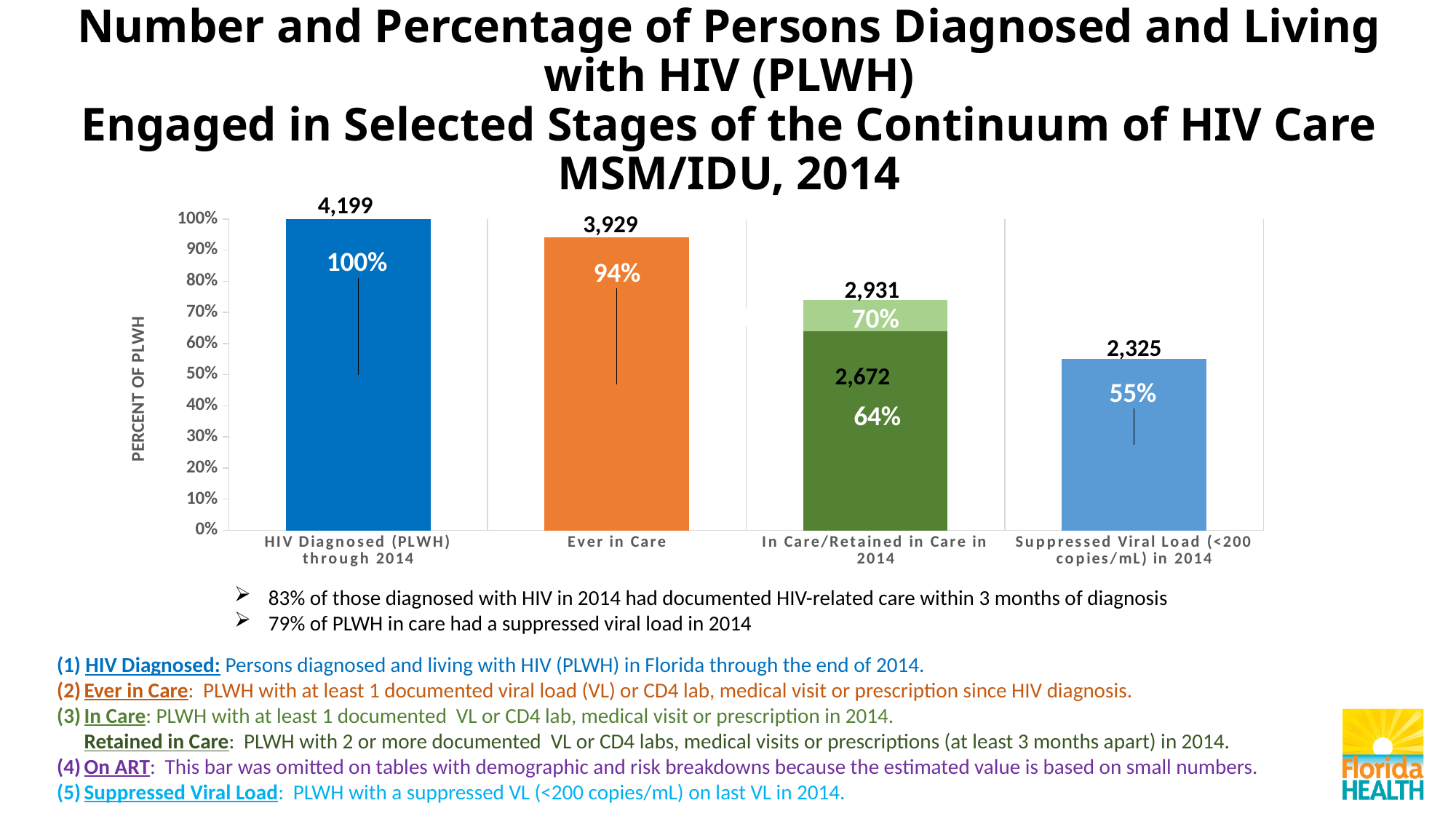
How many categories are shown on the x axis of the chart? 4 Is the value for Suppressed Viral Load (<200 copies/mL) in 2014 greater or less than 60%? less What number is printed inside the dark green portion of the In Care/Retained in Care in 2014 bar? 2,672 What number is printed above the bar for HIV Diagnosed (PLWH) through 2014? 4,199 Which category has the highest bar? HIV Diagnosed (PLWH) through 2014 What number is printed above the In Care/Retained in Care in 2014 bar? 2,931 Which is larger, the percentage for Ever in Care or the percentage for Suppressed Viral Load (<200 copies/mL) in 2014? Ever in Care What kind of chart is shown on the slide? bar chart What is the difference between the number for HIV Diagnosed (PLWH) through 2014 and the number for Ever in Care? 270 What percentage is shown on the Ever in Care bar? 94% Which category has the lowest bar? Suppressed Viral Load (<200 copies/mL) in 2014 What percentage is shown on the Suppressed Viral Load (<200 copies/mL) in 2014 bar? 55%